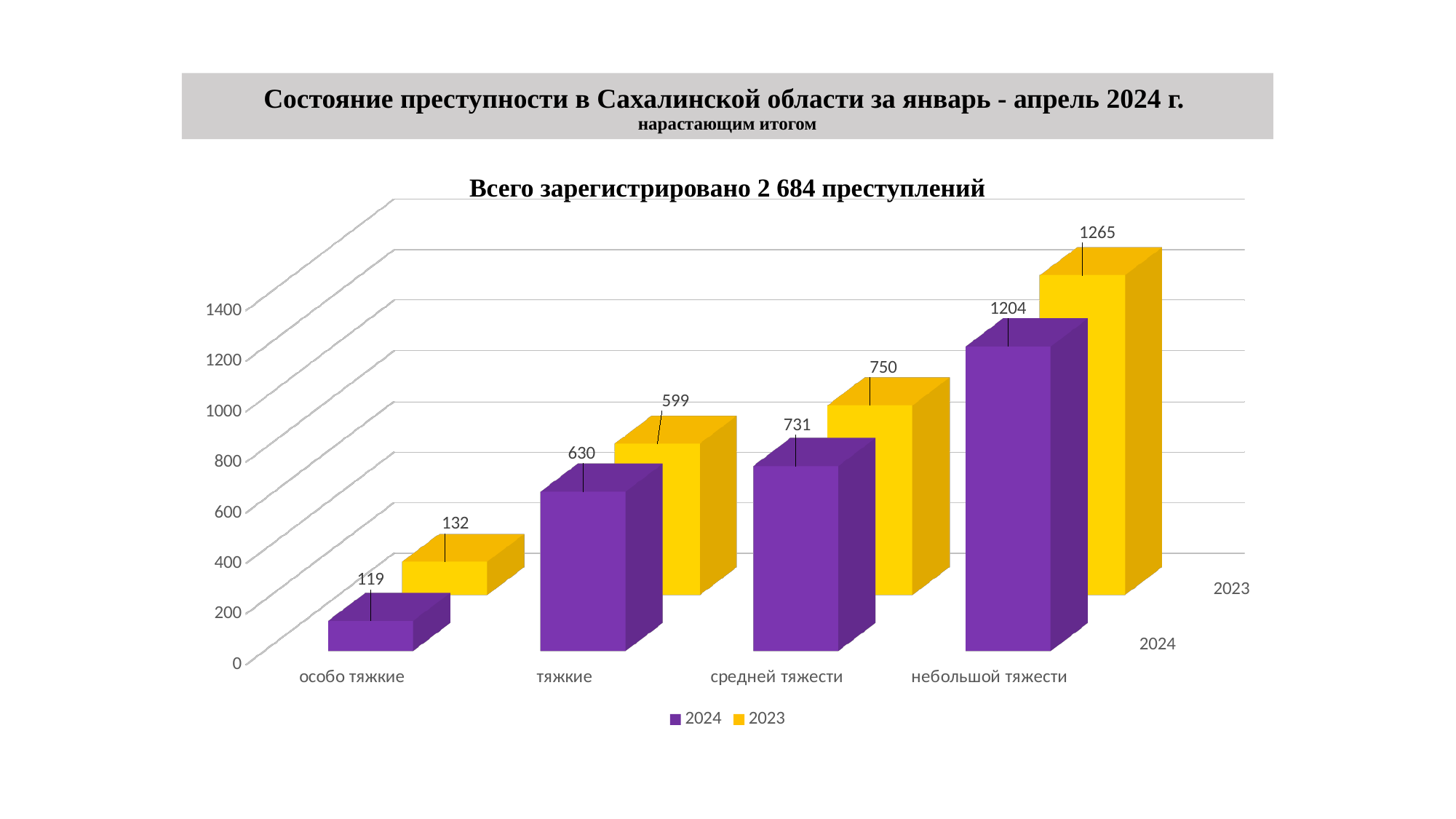
How many categories are shown on the x axis? 4 What is the value for 'тяжкие' in the 2024 series? 630 How many series does the legend list? 2 What is the value for 'средней тяжести' in the 2023 series? 750 What is the title shown directly above the chart? Всего зарегистрировано 2 684 преступлений Which category has the highest value in the 2024 series? небольшой тяжести What is the value for 'особо тяжкие' in the 2024 series? 119 Which is larger for 'тяжкие': the 2024 value or the 2023 value? 2024 Which category has the lowest value in the 2023 series? особо тяжкие What kind of chart is shown on the slide? bar chart What is the value for 'небольшой тяжести' in the 2023 series? 1265 What is the difference between the 2023 and 2024 values for 'небольшой тяжести'? 61